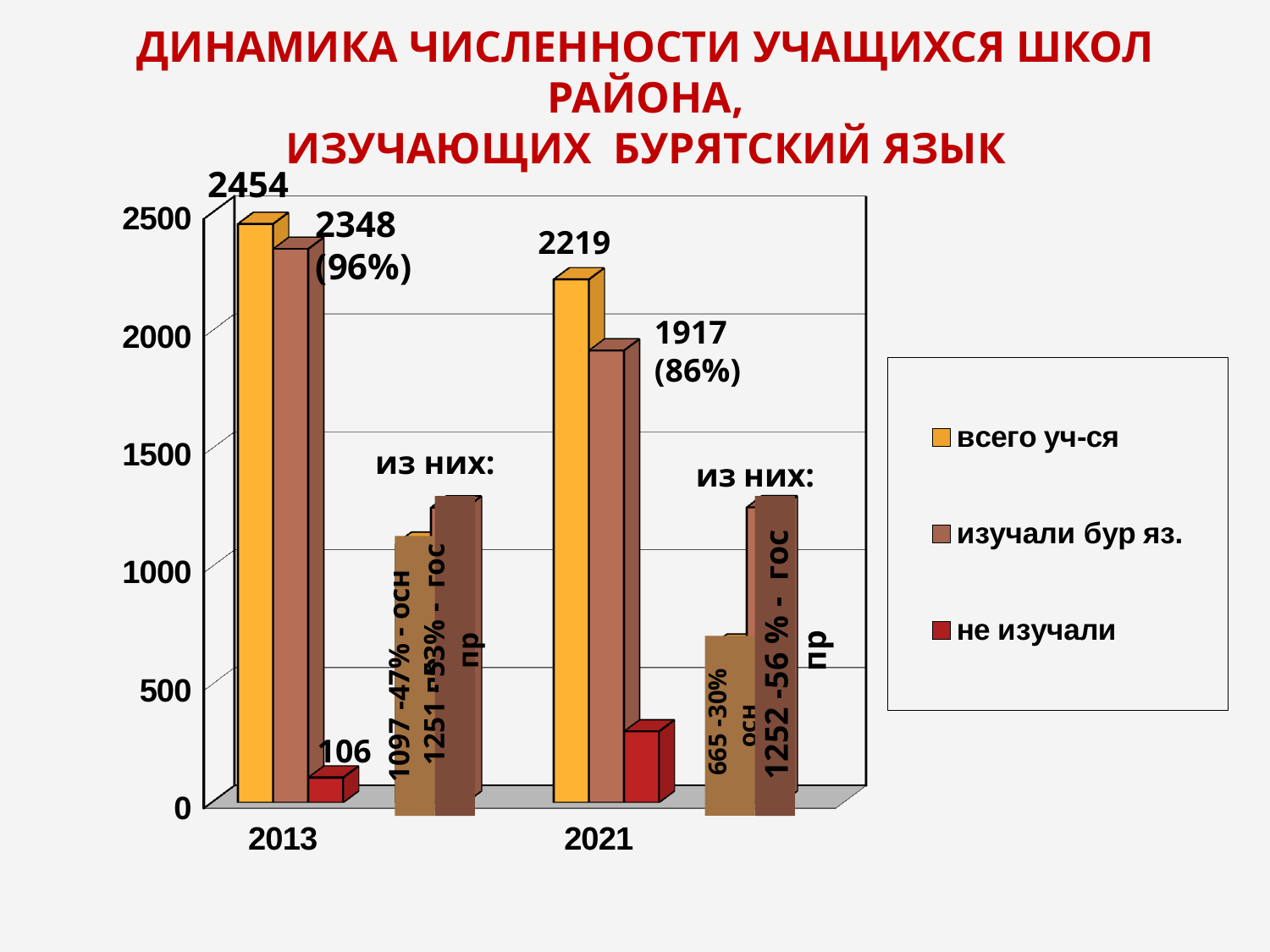
What is the value for "всего уч-ся" in 2013? 2454 Which colour represents the "не изучали" series in the legend? red What is the value for "изучали бур яз." in 2021? 1917 (86%) What is the difference between the "всего уч-ся" values for 2013 and 2021? 235 Is the value for "не изучали" in 2021 greater or less than 500? less How many series does the legend list? 3 What is the value for "не изучали" in 2013? 106 What is the value for "изучали бур яз." in 2013? 2348 (96%) What is the value for "всего уч-ся" in 2021? 2219 Does the value for "всего уч-ся" rise or fall from 2013 to 2021? fall What kind of chart is shown on the slide? bar chart Which year has the larger value for "изучали бур яз.", 2013 or 2021? 2013